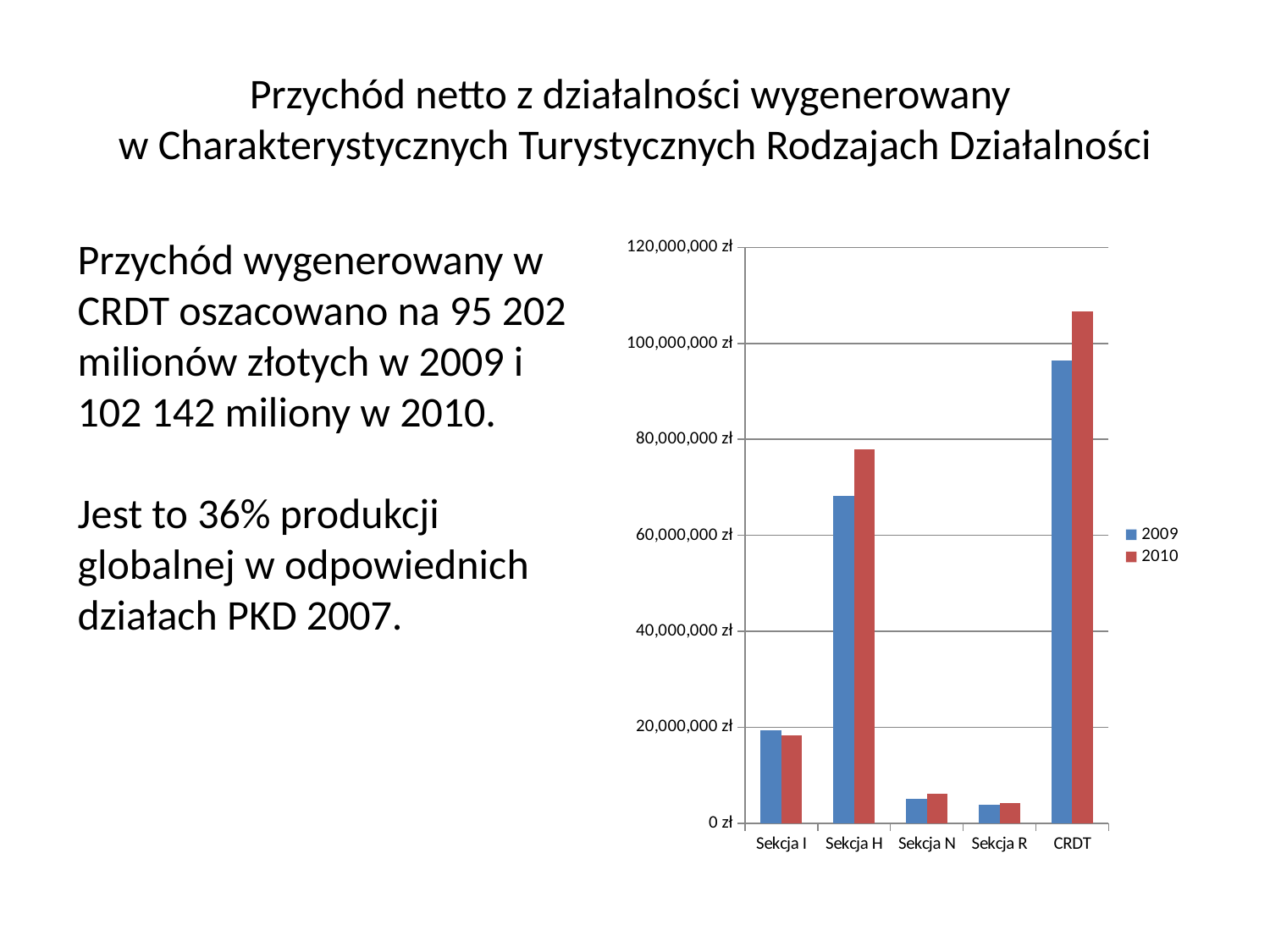
Is the 2010 value for CRDT greater or less than 100,000,000 zł? greater Which is larger for Sekcja I: the 2009 value or the 2010 value? 2009 Which is larger for Sekcja H: the 2009 value or the 2010 value? 2010 Which series is shown in red in the chart? 2010 How many series does the chart legend list? 2 What is the highest value shown on the chart's vertical axis? 120,000,000 zł What kind of chart is shown on the slide? bar chart Is the 2009 value for Sekcja N greater or less than 20,000,000 zł? less Which category has the highest value for 2010? CRDT How many categories are shown on the x axis of the chart? 5 Is the 2009 value for Sekcja H greater or less than 80,000,000 zł? less Which category has the lowest value for 2009? Sekcja R